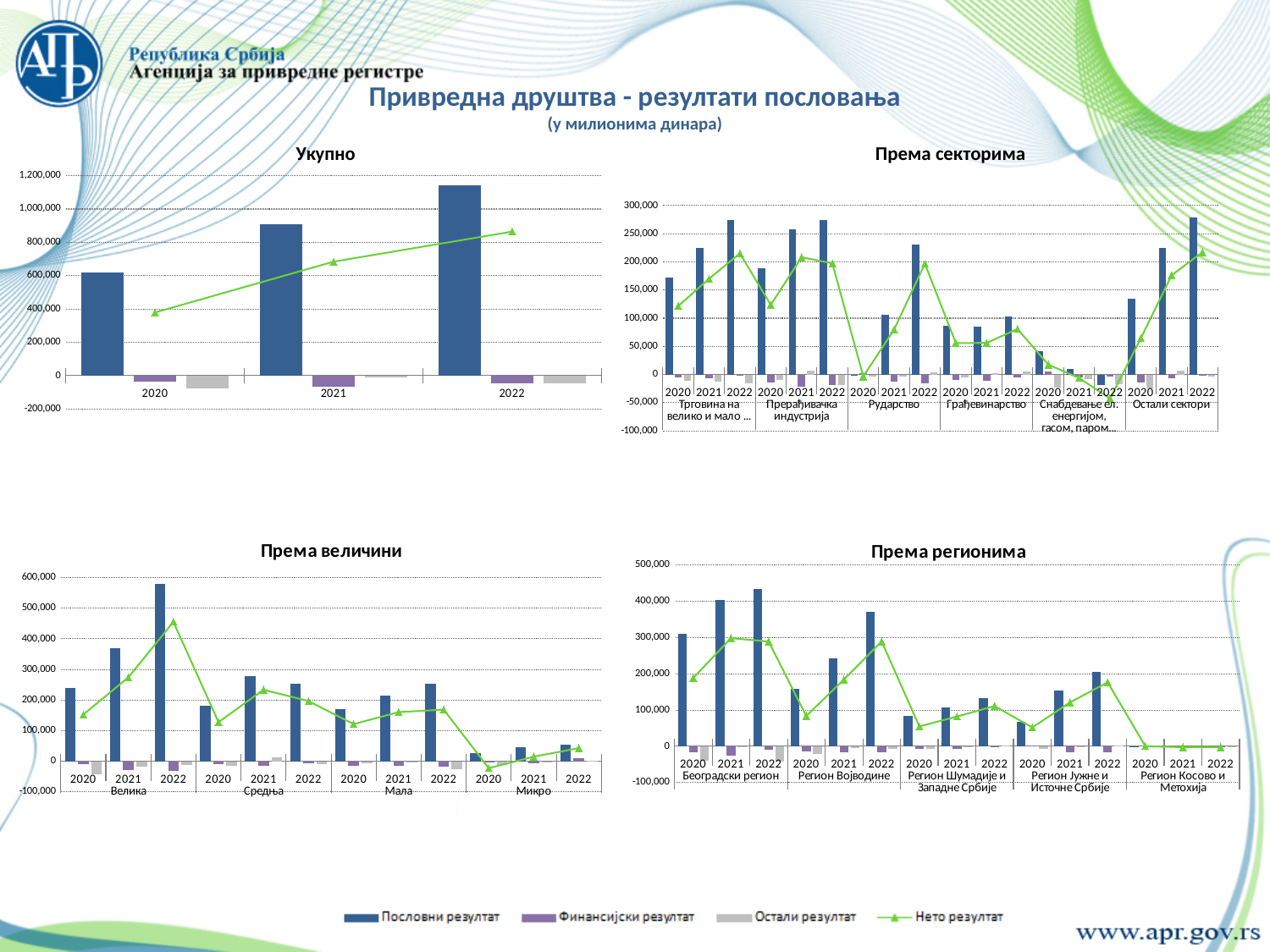
On the 'Укупно' chart, does the Нето резултат line rise or fall from 2020 to 2022? rises On the 'Укупно' chart, is the Пословни резултат bar for 2020 greater or less than 800,000? less What kind of chart is the 'Укупно' chart? bar and line chart On the 'Према секторима' chart, how many sectors are shown on the x axis? 6 On the 'Према регионима' chart, which is larger in 2022: the Пословни резултат bar for Регион Војводине or for Регион Шумадије и Западне Србије? Регион Војводине How many series does the legend at the bottom of the slide list? 4 On the 'Према величини' chart, which size category and year has the highest Пословни резултат bar? Велика, 2022 On the 'Према секторима' chart, is the Пословни резултат bar for Рударство in 2022 greater or less than 200,000? greater On the 'Према регионима' chart, how many regions are shown on the x axis? 5 On the 'Према величини' chart, is the Пословни резултат bar for Велика in 2022 greater or less than 500,000? greater On the 'Укупно' chart, which year has the highest Пословни резултат bar? 2022